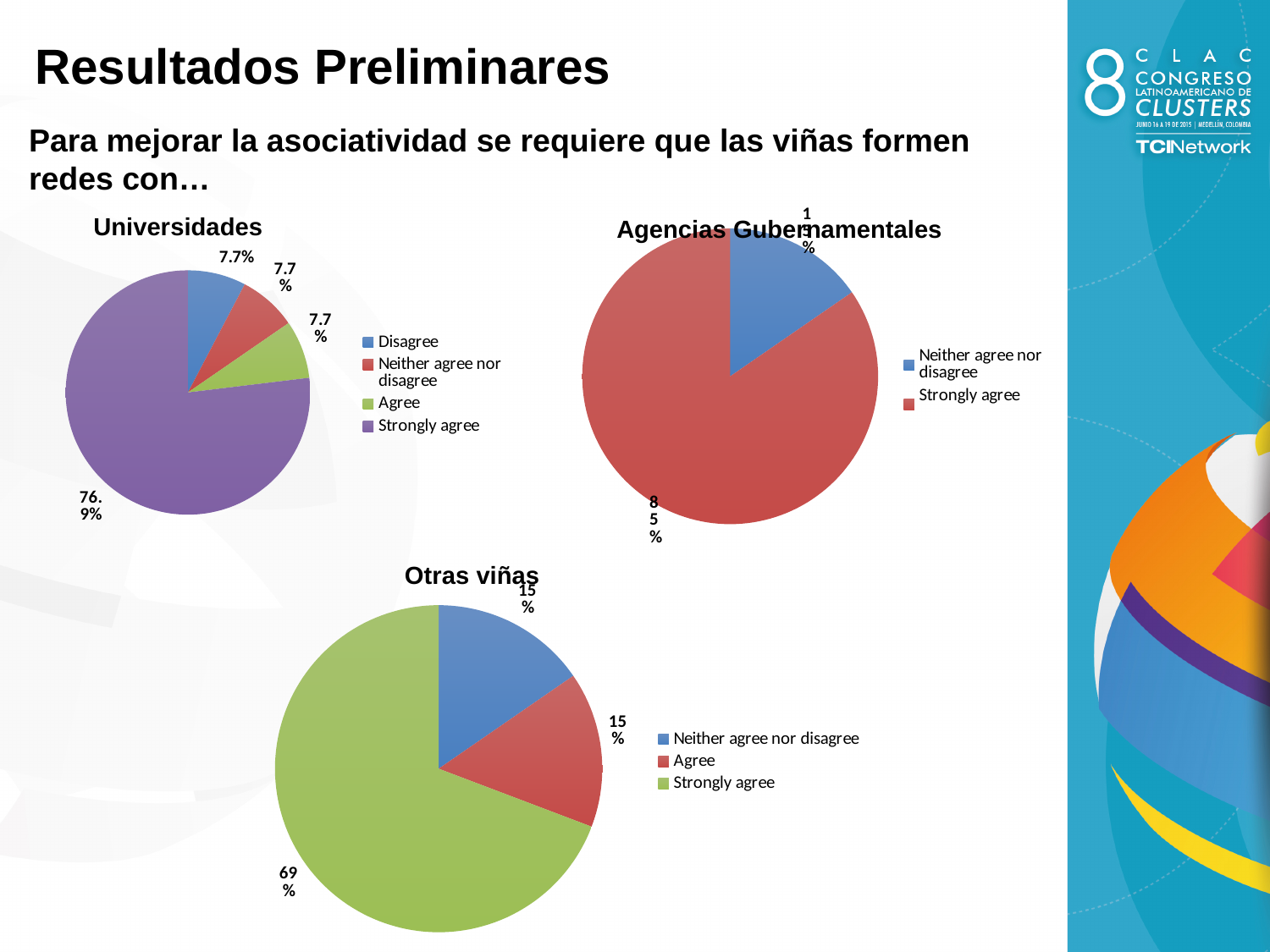
In the Universidades chart, what is the difference between the Strongly agree and Agree percentages? 69.2% In the Agencias Gubernamentales chart, which category has the largest slice? Strongly agree How many entries does the legend of the Agencias Gubernamentales chart list? 2 In the Universidades chart, which category has the largest slice? Strongly agree What type of chart is used for Otras viñas? Pie chart In the Agencias Gubernamentales chart, what percentage is shown for Strongly agree? 85% In the Universidades chart, what percentage is shown for Strongly agree? 76.9% How many slices does the Universidades pie chart have? 4 In the Otras viñas chart, what percentage is shown for Agree? 15% In the Otras viñas chart, what percentage is shown for Strongly agree? 69% In the Universidades chart, what percentage is shown for Disagree? 7.7% In the Otras viñas chart, what is the difference between the Strongly agree and Agree percentages? 54%